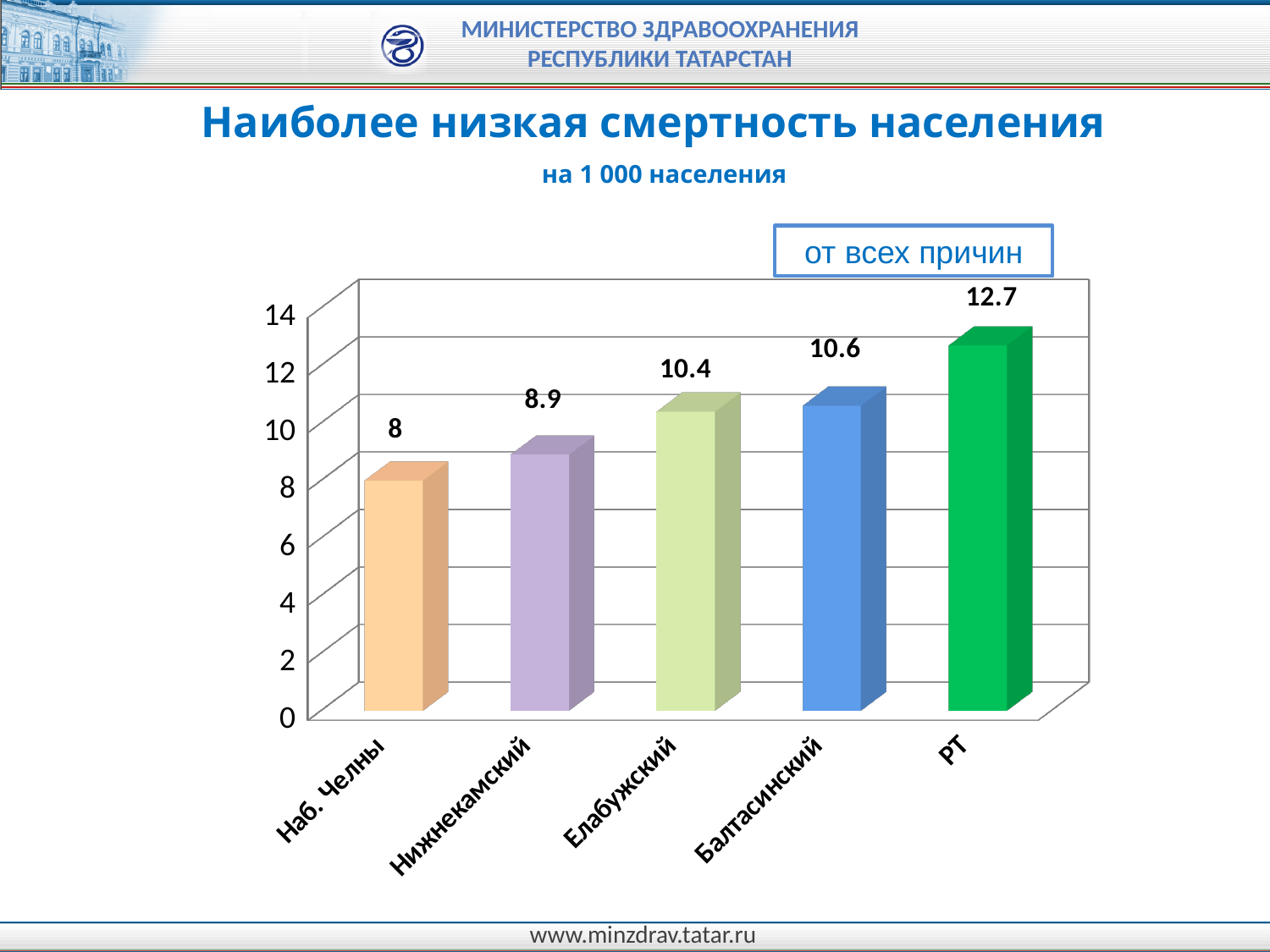
Which category has the highest value? РТ Do the values rise or fall from left to right along the x axis? rise What is the value for РТ? 12.7 Which category has the lowest value? Наб. Челны What kind of chart is shown on the slide? bar chart How many categories are shown on the x axis? 5 Which is larger, the value for Нижнекамский or the value for Елабужский? Елабужский What is the value for Наб. Челны? 8 What is the value for Балтасинский? 10.6 What is the value for Нижнекамский? 8.9 What is the difference between the values for РТ and Наб. Челны? 4.7 What is the value for Елабужский? 10.4